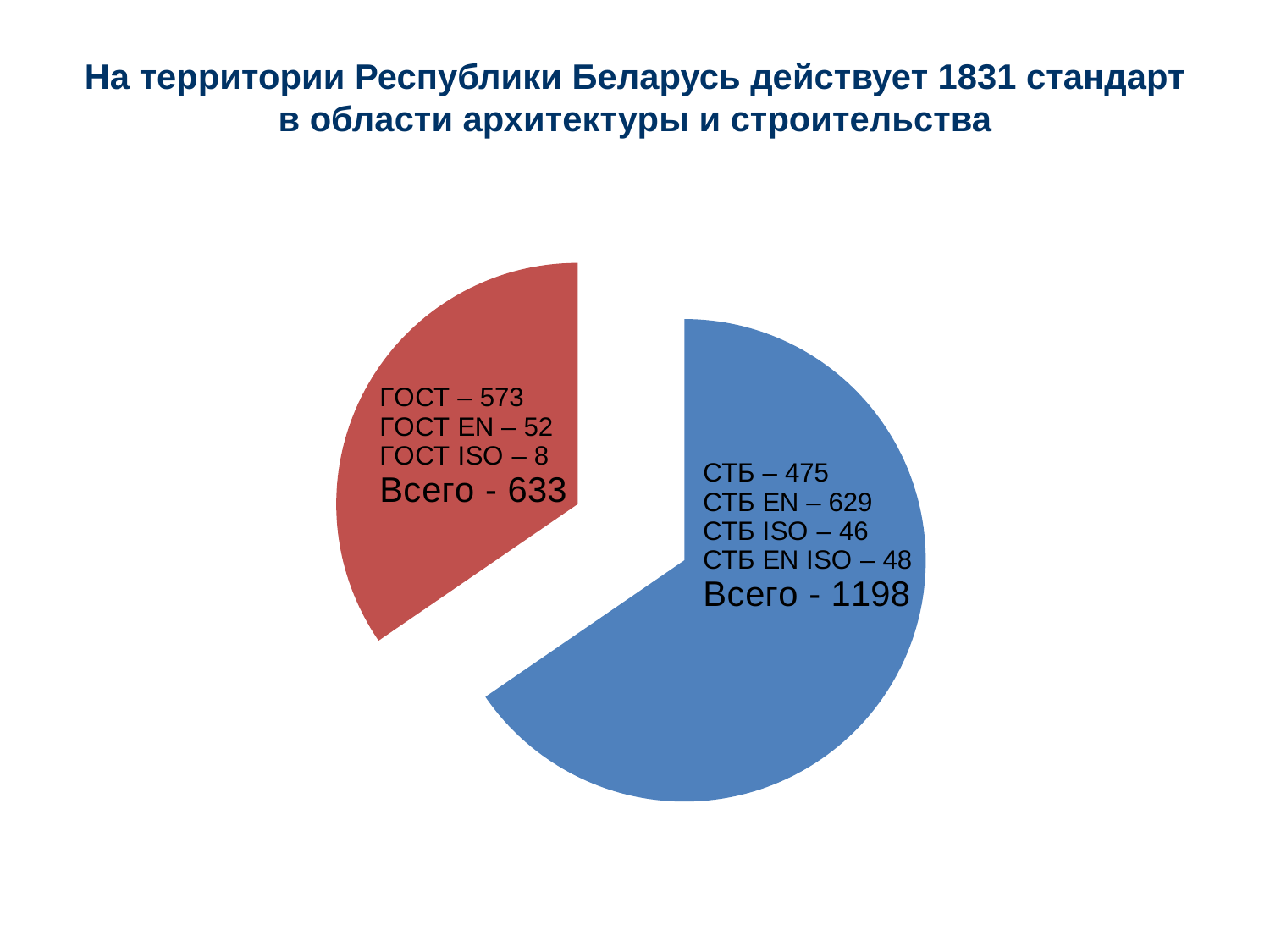
What is the total (Всего) shown for the ГОСТ slice of the pie chart? 633 What is the difference between the СТБ total (1198) and the ГОСТ total (633)? 565 How many СТБ EN standards are listed in the pie chart? 629 Which slice of the pie chart is larger, ГОСТ or СТБ? СТБ What colour is the СТБ slice of the pie chart? blue What kind of chart is shown on the slide? pie chart What is the total (Всего) shown for the СТБ slice of the pie chart? 1198 How many slices does the pie chart have? 2 What is the combined total of the two slices of the pie chart? 1831 How many ГОСТ standards (plain ГОСТ) are listed in the pie chart? 573 Which is larger, the number of ГОСТ EN standards or the number of СТБ ISO standards? ГОСТ EN How many ГОСТ ISO standards are listed in the pie chart? 8